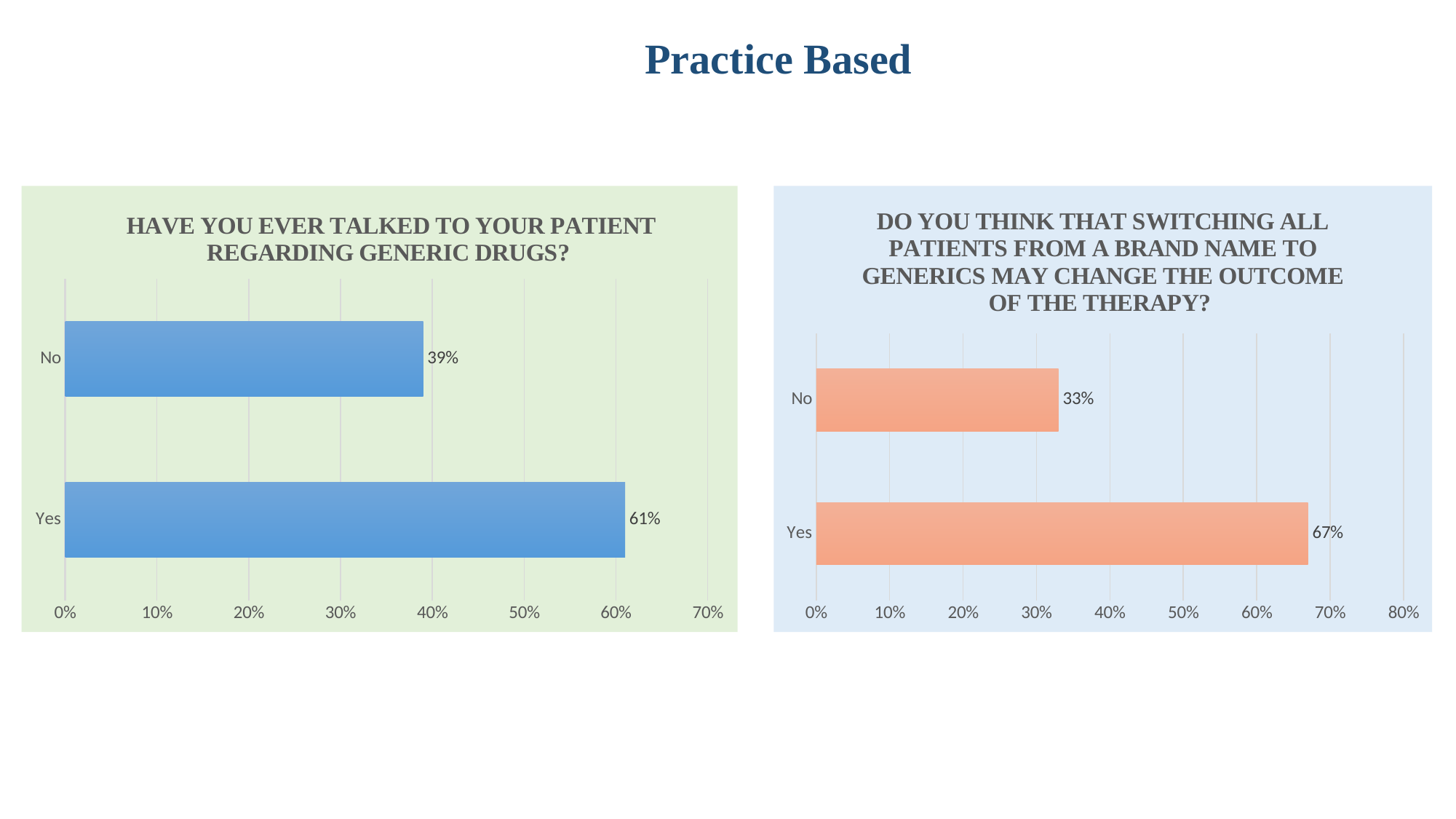
In the left chart, what is the difference between the Yes and No values? 22% In the right chart, which category has the lowest value? No In the right chart, is the value for No greater or less than 40%? less How many categories are shown in the left chart? 2 In the right chart ("Do you think that switching all patients from a brand name to generics may change the outcome of the therapy?"), what is the value for Yes? 67% In the left chart ("Have you ever talked to your patient regarding generic drugs?"), what is the value for No? 39% Which is larger: the Yes value in the left chart or the Yes value in the right chart? The Yes value in the right chart What kind of chart is the right chart? Bar chart In the left chart, which category has the highest value? Yes In the right chart ("Do you think that switching all patients from a brand name to generics may change the outcome of the therapy?"), what is the value for No? 33% In the left chart ("Have you ever talked to your patient regarding generic drugs?"), what is the value for Yes? 61% In the right chart, what is the difference between the Yes and No values? 34%